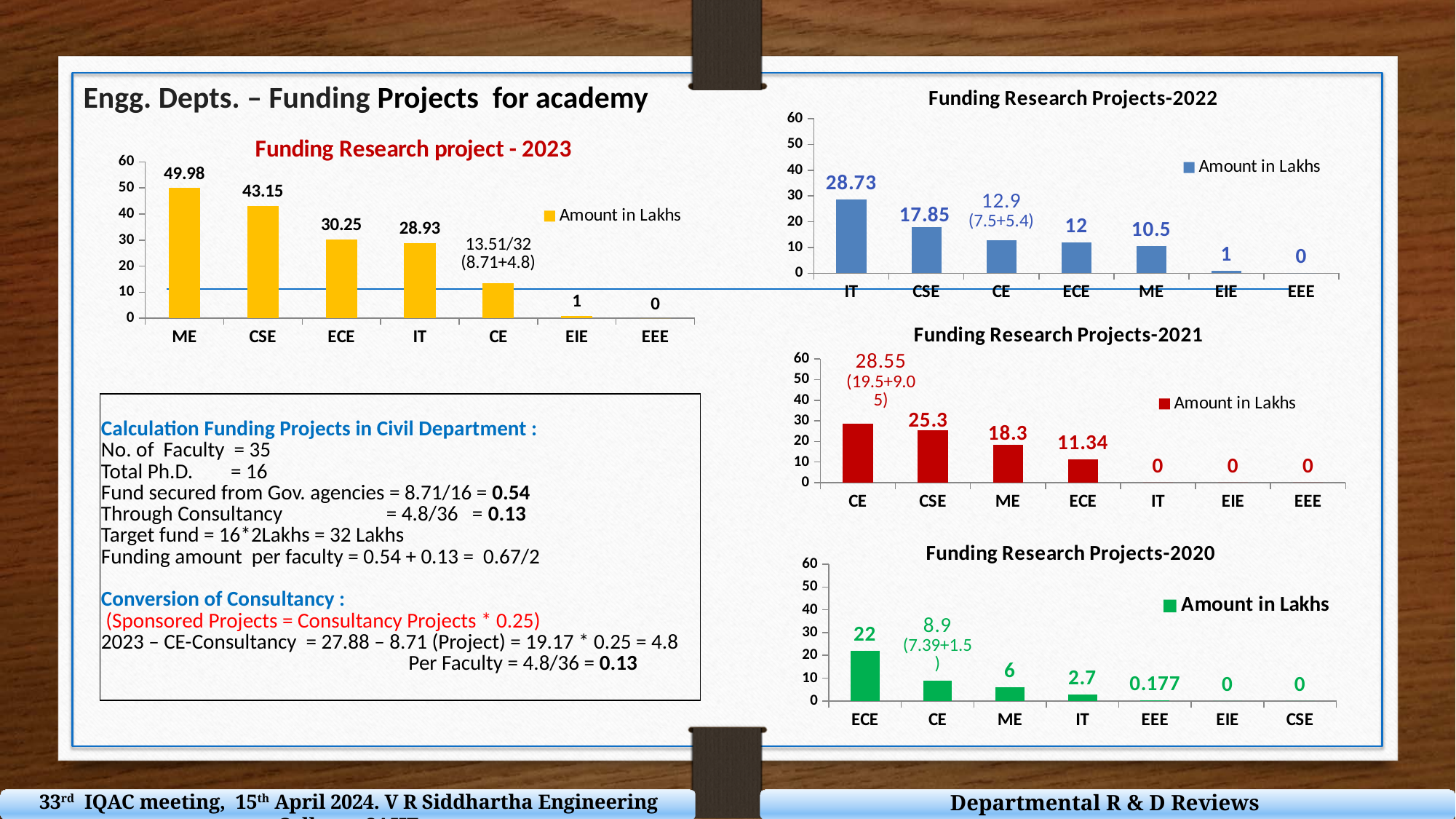
In the 'Funding Research Projects-2022' chart, how many departments are shown on the x axis? 7 In the 'Funding Research Projects-2022' chart, what is the value for IT? 28.73 In the 'Funding Research Projects-2020' chart, is the value for ECE greater or less than 20? greater In the 'Funding Research Projects-2021' chart, what is the difference between the values for ME and ECE? 6.96 In the 'Funding Research Projects-2021' chart, which department has the highest value? CE What type of chart is the 'Funding Research Projects-2020' chart? Bar chart In the 'Funding Research Projects-2022' chart, which is larger, the value for CSE or the value for ME? CSE In the 'Funding Research Projects-2021' chart, what is the value for CSE? 25.3 In the 'Funding Research project - 2023' chart, what is the difference between the values for CSE and ECE? 12.9 In the 'Funding Research project - 2023' chart, what is the value for ME? 49.98 In the 'Funding Research Projects-2020' chart, what is the value for EEE? 0.177 In the 'Funding Research project - 2023' chart, which department has the highest value? ME